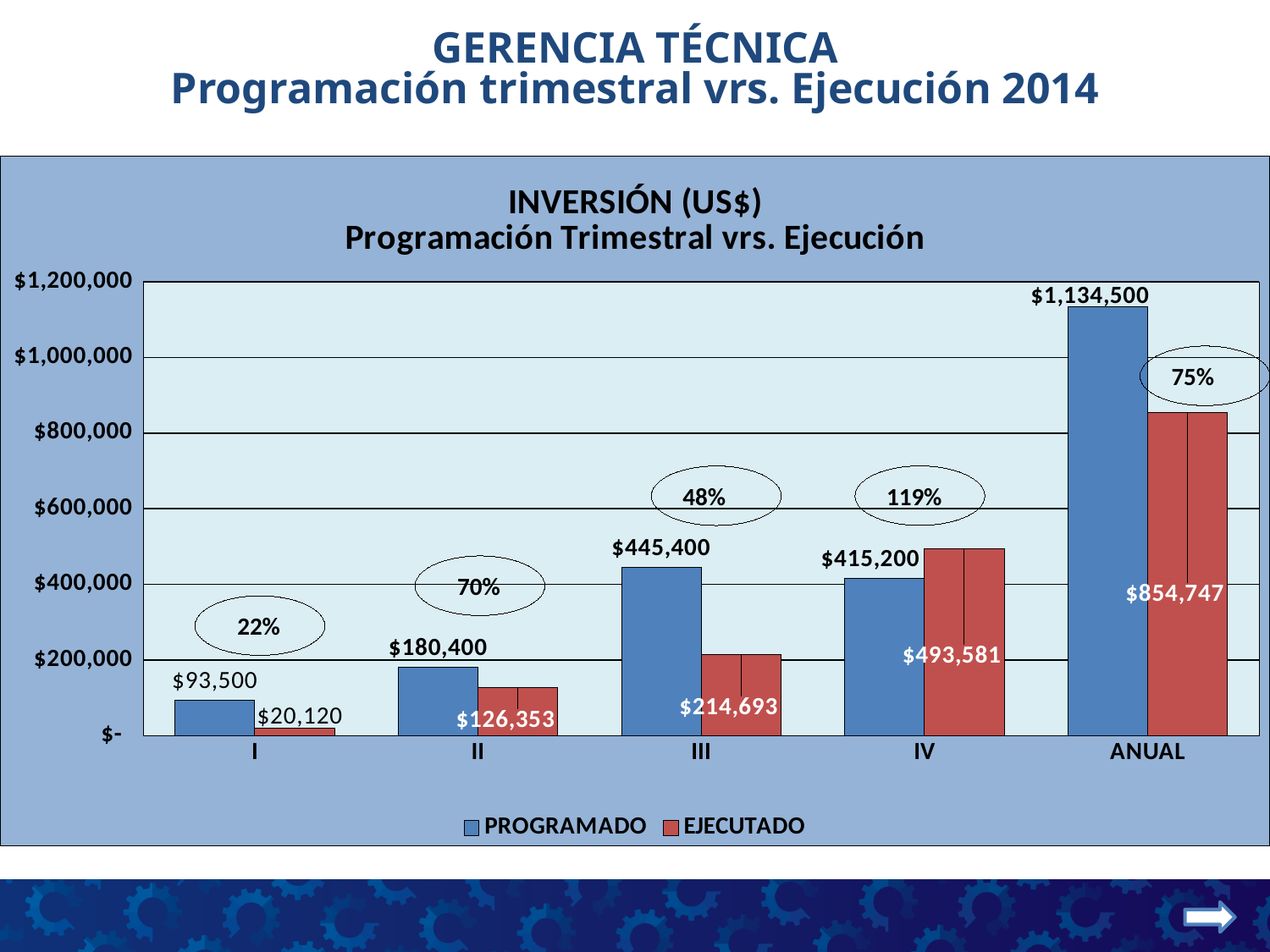
Which quarter (excluding ANUAL) has the highest PROGRAMADO value? III Is the EJECUTADO value for quarter II greater or less than $200,000? less What is the PROGRAMADO value for quarter III? $445,400 What is the difference between the PROGRAMADO and EJECUTADO values for ANUAL? $279,753 What is the EJECUTADO value for ANUAL? $854,747 How many categories are shown on the x axis? 5 Which category has the lowest EJECUTADO value? I What percentage is shown in the circle above quarter IV? 119% What is the EJECUTADO value for quarter IV? $493,581 What is the PROGRAMADO value for quarter I? $93,500 In quarter IV, which is larger, PROGRAMADO or EJECUTADO? EJECUTADO How many series does the legend list? 2